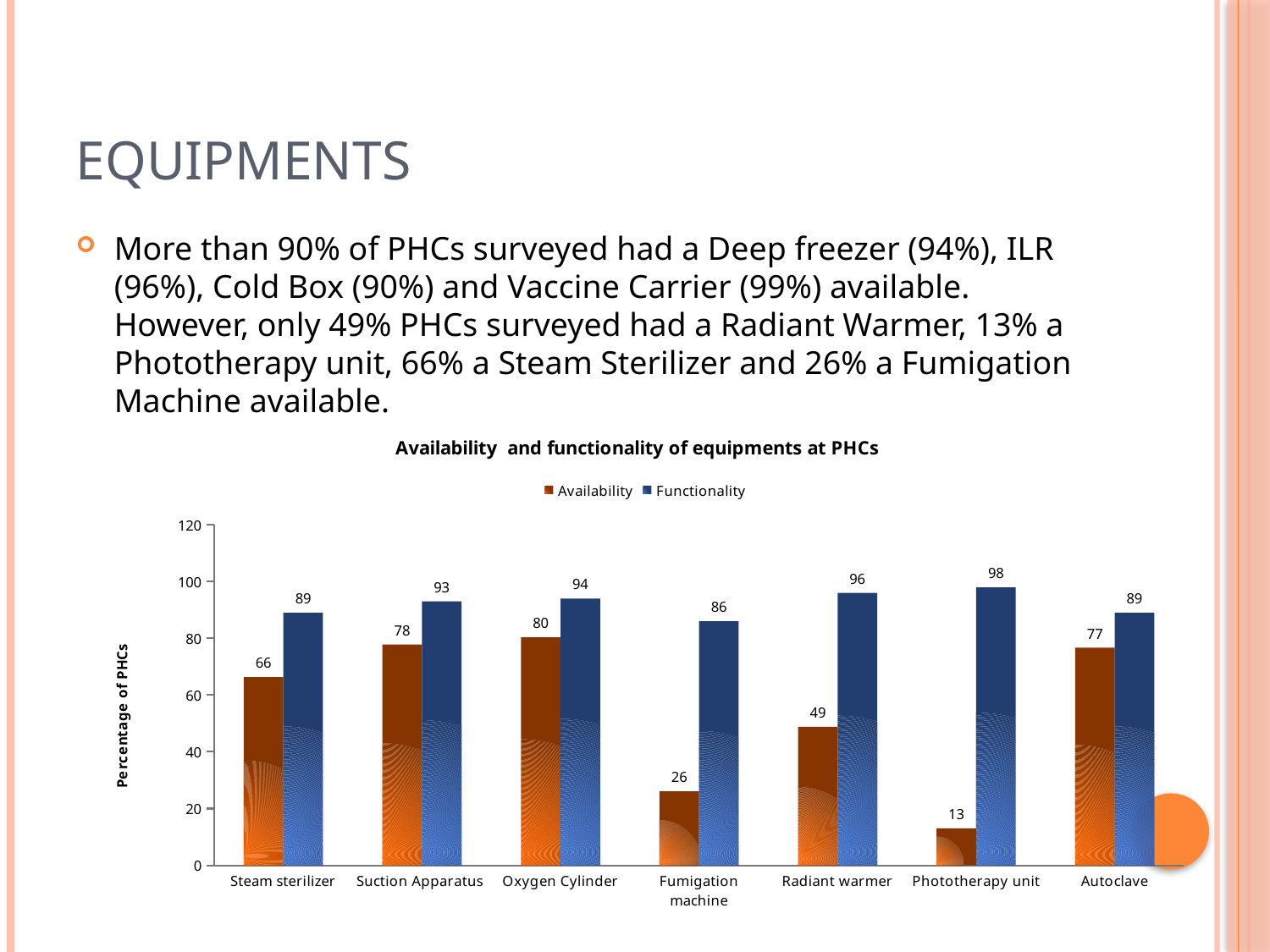
Which is larger, the Availability value for Suction Apparatus or the Availability value for Autoclave? Suction Apparatus Which category has the highest Functionality value? Phototherapy unit What is the Availability value for Fumigation machine? 26 Which category has the highest Availability value? Oxygen Cylinder How many series does the legend list? 2 What kind of chart is shown on the slide? Bar chart What is the Functionality value for Phototherapy unit? 98 How many categories are shown on the x axis? 7 What is the Availability value for Steam sterilizer? 66 What is the difference between the Functionality and Availability values for Radiant warmer? 47 What is the title of the chart? Availability and functionality of equipments at PHCs Which category has the lowest Availability value? Phototherapy unit